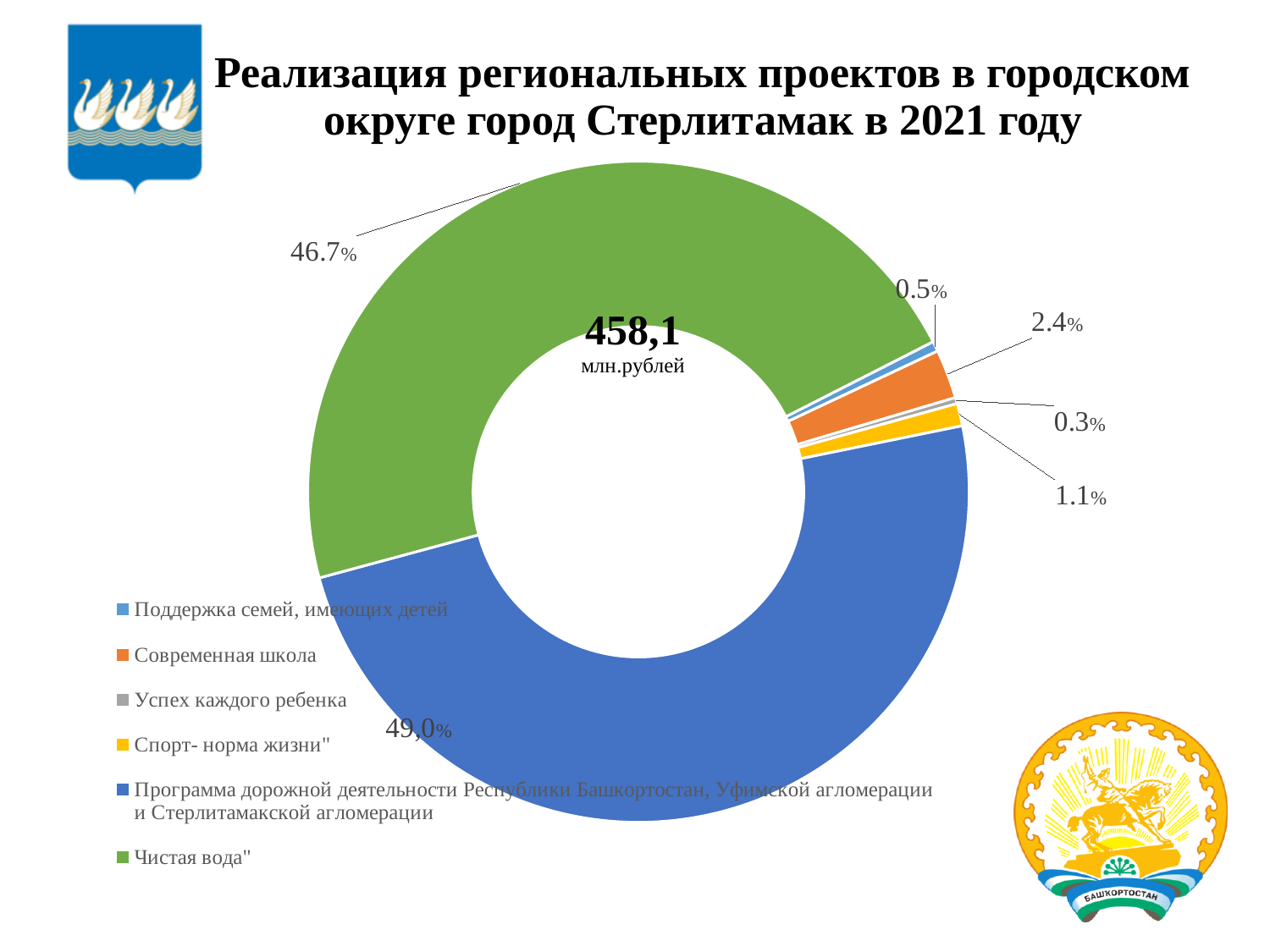
What share of the chart does "Поддержка семей, имеющих детей" have? 0.5% What share of the chart does "Чистая вода" have? 46.7% How many categories does the chart show? 6 Which category has the smallest share of the chart? Успех каждого ребенка What share of the chart does "Спорт- норма жизни" have? 1.1% What is the difference in percentage points between the shares of "Программа дорожной деятельности" and "Чистая вода"? 2.3 What share of the chart does "Программа дорожной деятельности Республики Башкортостан, Уфимской агломерации и Стерлитамакской агломерации" have? 49,0% Which category has the largest share of the chart? Программа дорожной деятельности Республики Башкортостан, Уфимской агломерации и Стерлитамакской агломерации What share of the chart does "Современная школа" have? 2.4% What kind of chart is shown on the slide? Pie (donut) chart What total value is shown in the centre of the chart? 458,1 млн.рублей Which has the larger share: "Современная школа" or "Спорт- норма жизни"? Современная школа